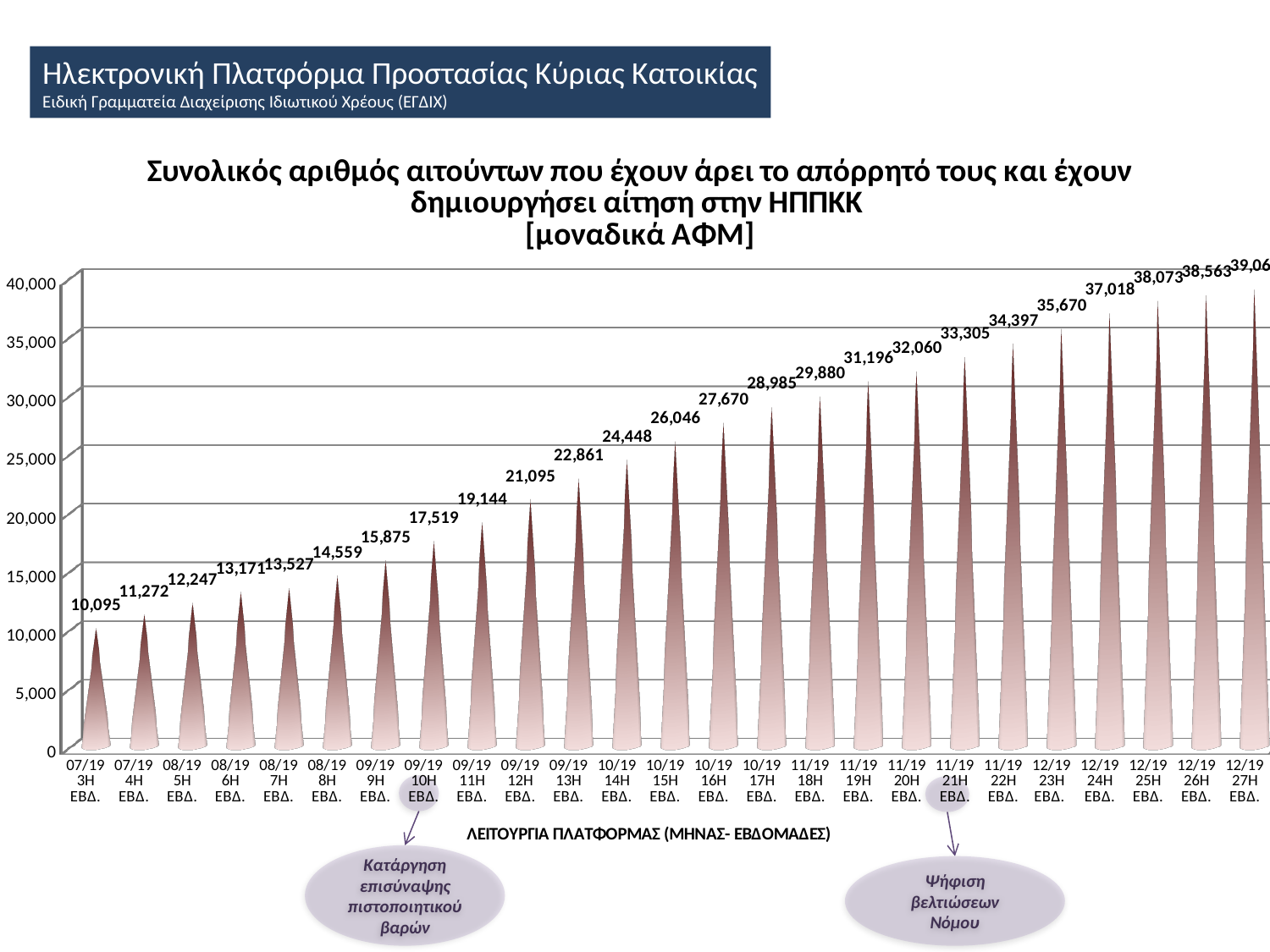
Which week has the highest value? 12/19 27Η ΕΒΔ. What is the difference between the values for 10/19 16Η ΕΒΔ. and 10/19 15Η ΕΒΔ.? 1,624 What is the value for 12/19 26Η ΕΒΔ.? 38,563 What is the value for 07/19 3Η ΕΒΔ.? 10,095 What is the value for 11/19 21Η ΕΒΔ.? 33,305 Do the values rise or fall from left to right along the x axis? rise Is the value for 11/19 19Η ΕΒΔ. greater or less than 30,000? greater Which is larger, the value for 09/19 12Η ΕΒΔ. or the value for 09/19 11Η ΕΒΔ.? 09/19 12Η ΕΒΔ. What kind of chart is shown on the slide? bar chart Which week has the lowest value? 07/19 3Η ΕΒΔ. What is the value for 09/19 10Η ΕΒΔ.? 17,519 How many weeks are plotted on the chart? 25